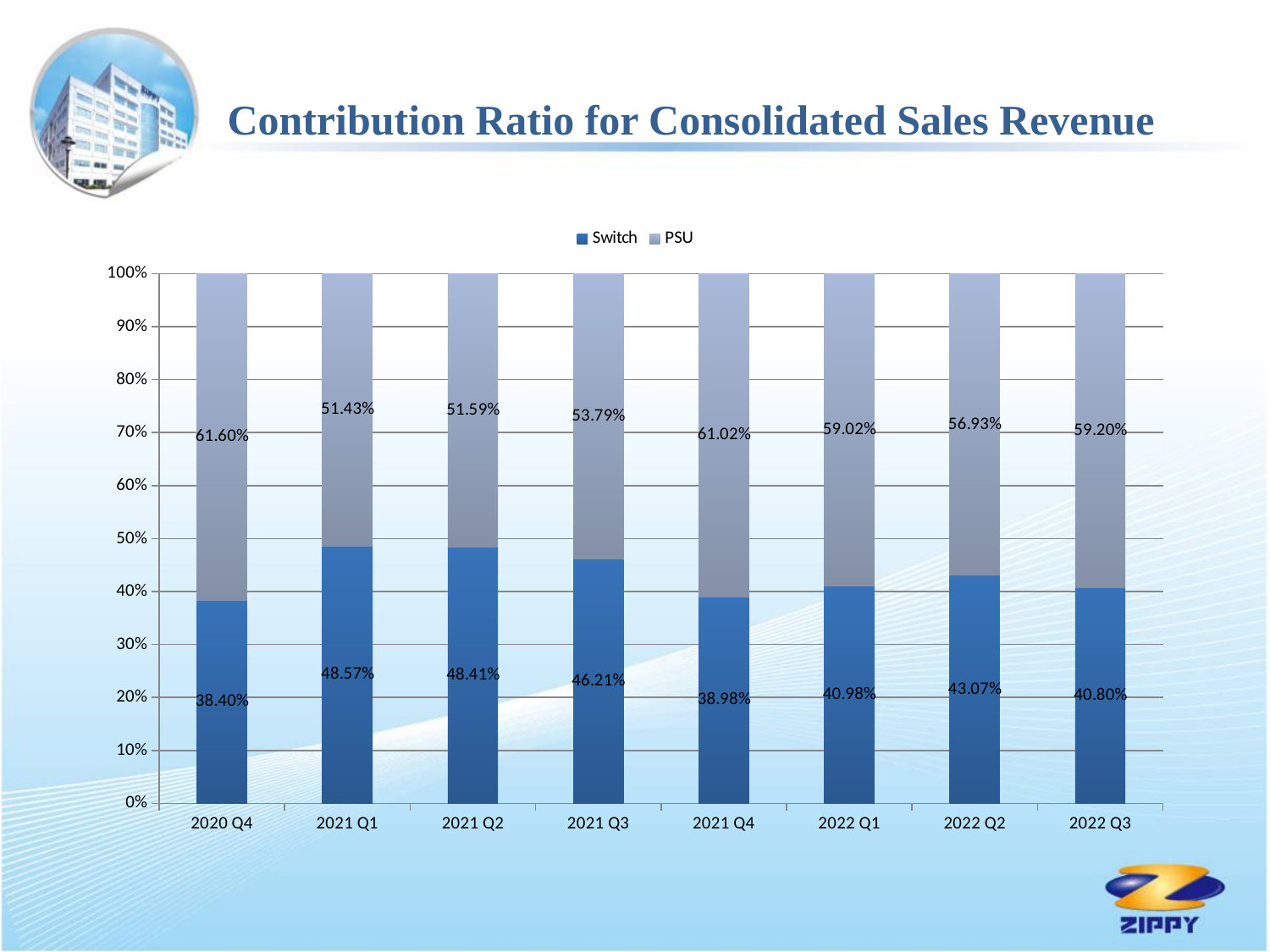
In which quarter is the Switch contribution ratio lowest? 2020 Q4 What is the Switch contribution ratio for 2021 Q4? 38.98% What is the PSU contribution ratio for 2022 Q2? 56.93% In which quarter is the Switch contribution ratio highest? 2021 Q1 How many quarters are shown on the x axis? 8 How many series does the legend list? 2 Which is larger in 2022 Q1, the Switch ratio or the PSU ratio? PSU What kind of chart is shown on the slide? Stacked bar chart What is the difference between the PSU and Switch contribution ratios in 2021 Q3? 7.58% In which quarter is the PSU contribution ratio lowest? 2021 Q1 By how much did the Switch contribution ratio change from 2022 Q2 to 2022 Q3? 2.27% What is the Switch contribution ratio for 2021 Q1? 48.57%